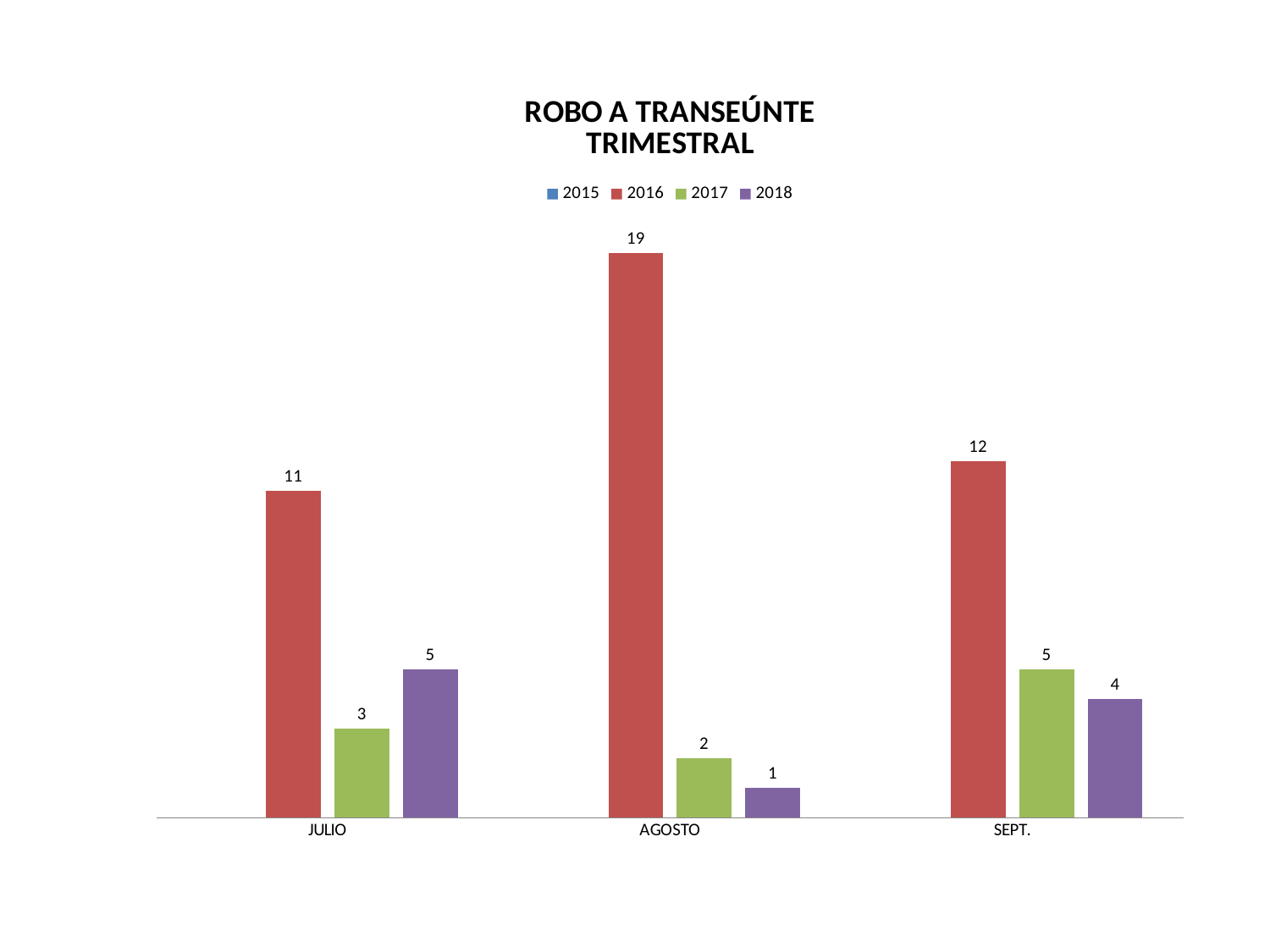
Which is larger in SEPT., the value for 2017 or the value for 2018? 2017 How many series does the legend list? 4 Which month has the lowest value for the 2018 series? AGOSTO Which month has the highest value for the 2016 series? AGOSTO How many months are shown on the x axis? 3 What is the value for 2016 in AGOSTO? 19 What is the value for 2018 in JULIO? 5 What is the difference between the 2016 and 2017 values in JULIO? 8 What is the title of the chart? ROBO A TRANSEÚNTE TRIMESTRAL What is the difference between the 2016 values for AGOSTO and SEPT.? 7 What is the value for 2017 in SEPT.? 5 What kind of chart is shown on the slide? Bar chart